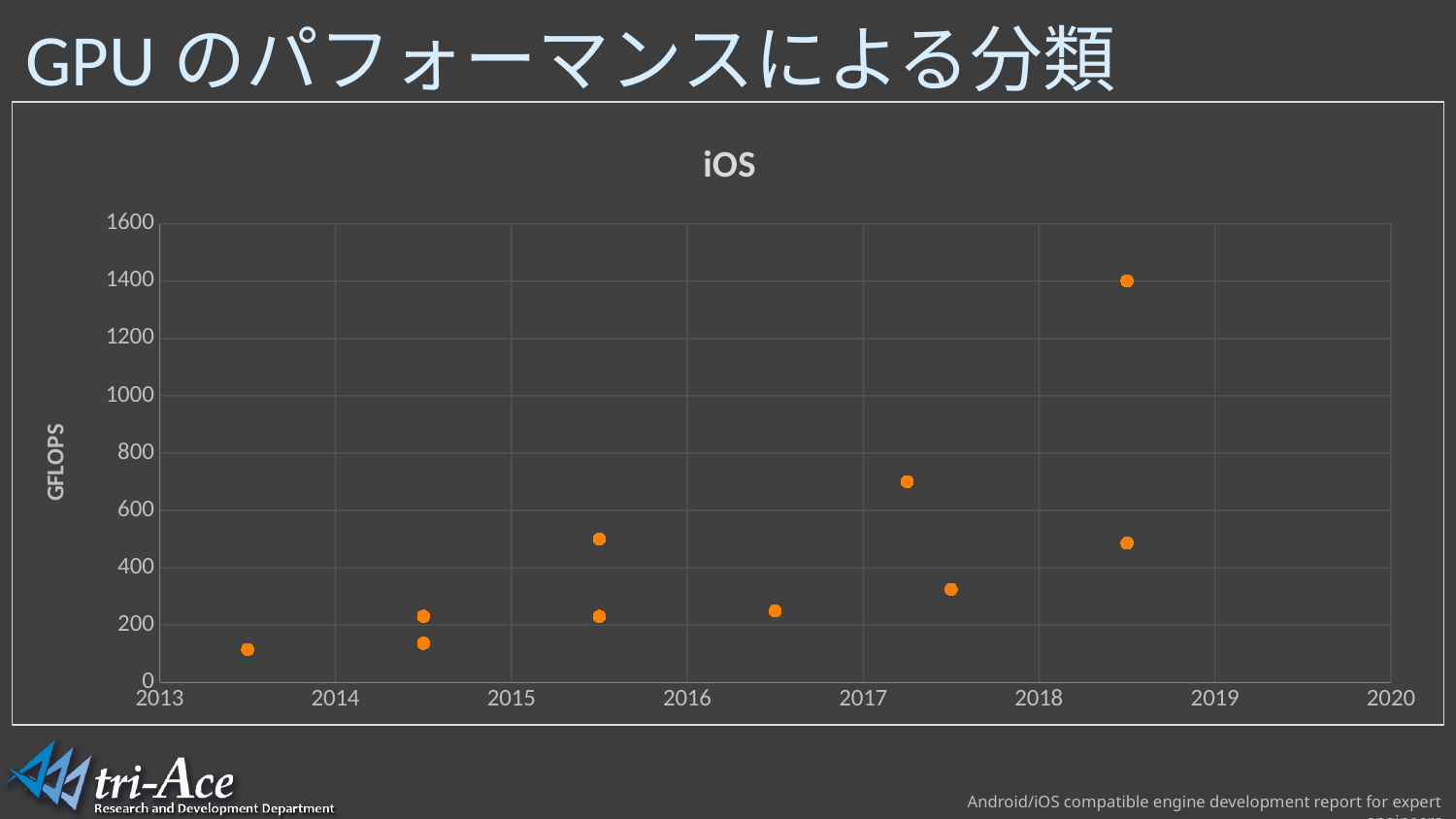
Is the value of the point plotted in early 2017 greater or less than 600 GFLOPS? greater What kind of chart is shown on the slide? scatter chart Is the higher of the two points plotted in 2015 greater or less than 400 GFLOPS? greater Is the value of the point plotted in 2016 greater or less than 400 GFLOPS? less How many data points are plotted on the chart? 10 Which is larger: the highest point plotted in 2018 or the point plotted in early 2017? the highest point in 2018 Do the GFLOPS values generally rise or fall as the years increase along the x axis? rise What is the title of the chart? iOS In which year does the highest GFLOPS value on the chart appear? 2018 What is the label on the vertical axis of the chart? GFLOPS